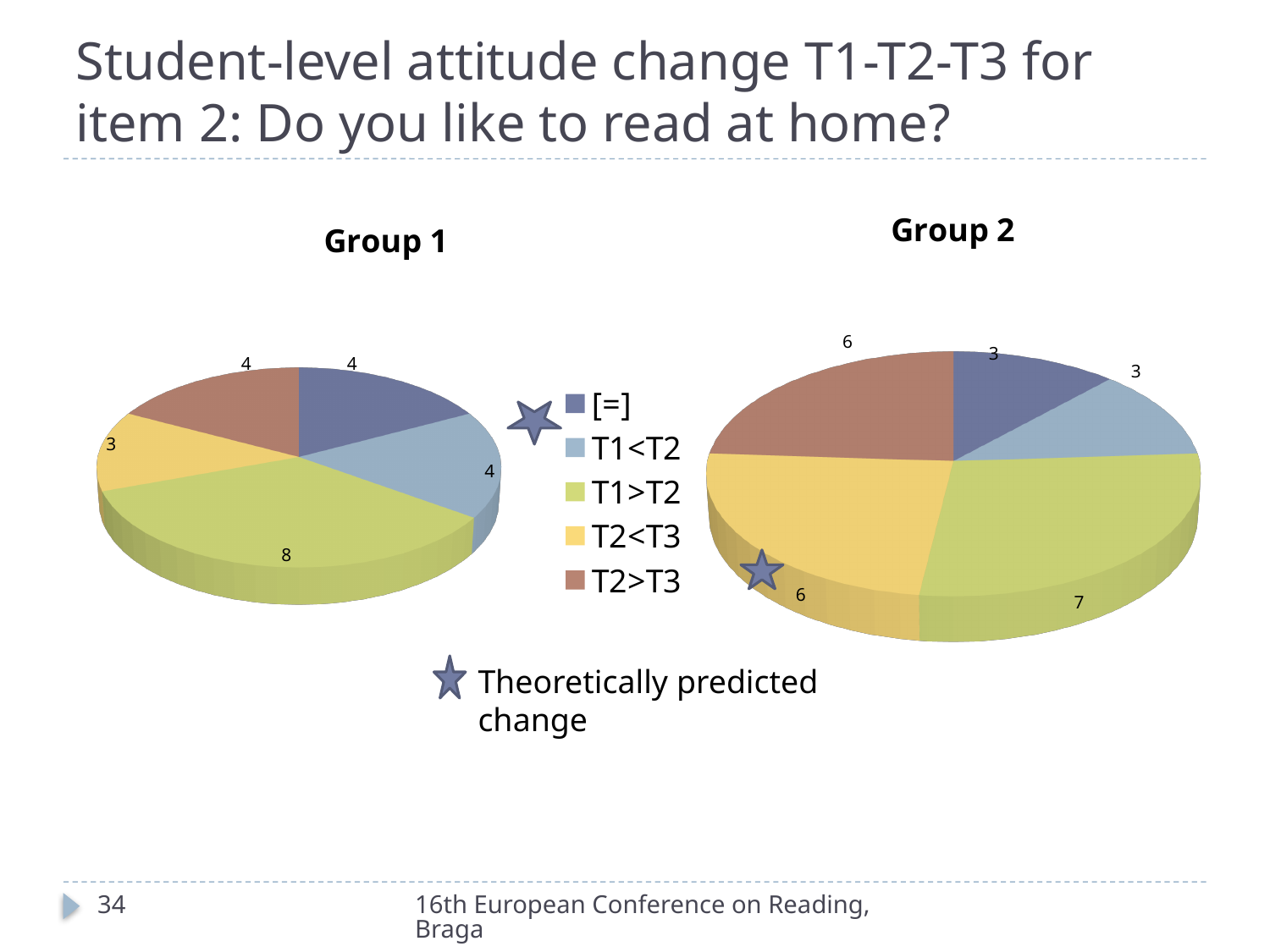
In the Group 1 chart, which is larger, T1>T2 or T2>T3? T1>T2 In the Group 1 chart, which category has the smallest slice? T2<T3 In the Group 2 chart, what is the value for T2<T3? 6 In the Group 1 chart, what is the value for T2<T3? 3 In the Group 2 chart, what is the value for [=]? 3 What kind of chart is the Group 2 chart? Pie chart In the Group 2 chart, what is the difference between T1>T2 and T1<T2? 4 In the Group 2 chart, what share of the total does T1>T2 represent? 28% How many categories does the legend list? 5 In the Group 1 chart, which category has the largest slice? T1>T2 In the Group 1 chart, what is the value for T1>T2? 8 In the Group 2 chart, which category has the largest slice? T1>T2